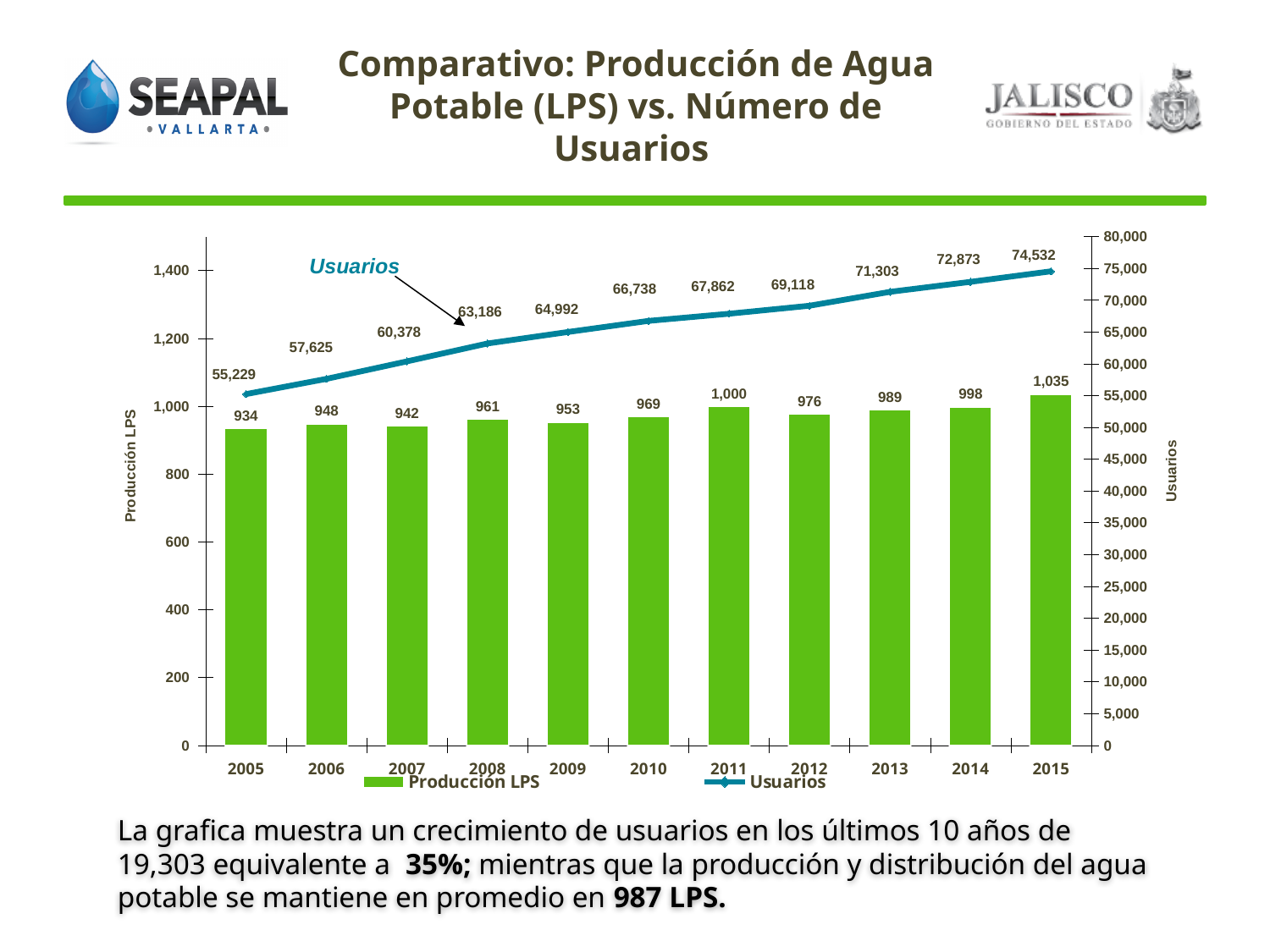
What kind of chart is shown on the slide? A combined bar and line chart What is the Usuarios value for 2012? 69,118 By how much did Usuarios increase from 2005 to 2015? 19,303 How many Usuarios are shown for 2008? 63,186 How many years are shown on the x axis? 11 How many series does the legend list? 2 Do the Usuarios values rise or fall from 2005 to 2015? Rise What is the difference in Producción LPS between 2015 and 2014? 37 What is the Producción LPS value for 2011? 1,000 Which year has the lowest Producción LPS? 2005 Which year has the larger Producción LPS, 2012 or 2013? 2013 Which year has the highest Producción LPS? 2015